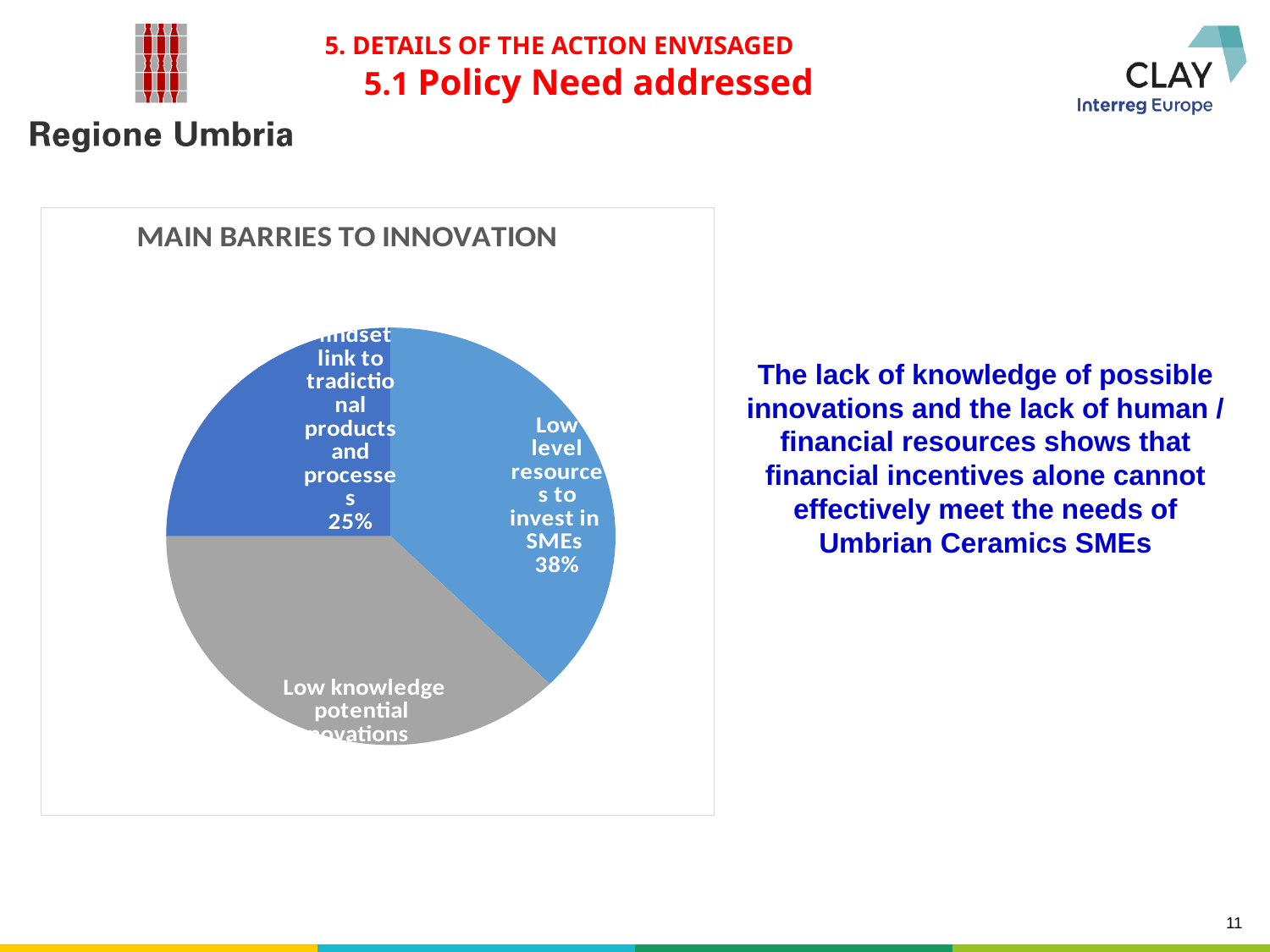
How many slices does the pie chart have? 3 What is the title of the chart on the slide? MAIN BARRIES TO INNOVATION Which is larger: the slice for "Low level resources to invest in SMEs" or the slice for mindset link to traditional products and processes? Low level resources to invest in SMEs What kind of chart is shown under the title "MAIN BARRIES TO INNOVATION"? Pie chart What percentage is shown for "Low level resources to invest in SMEs"? 38% What share of the pie does "Low level resources to invest in SMEs" represent? 38% Which slice of the pie chart is the smallest? Mindset link to traditional products and processes What is the difference in percentage points between the "Low level resources to invest in SMEs" slice and the mindset link to traditional products and processes slice? 13 percentage points What percentage is shown for the slice about mindset link to traditional products and processes? 25% What colour is the "Low knowledge potential innovations" slice? Grey